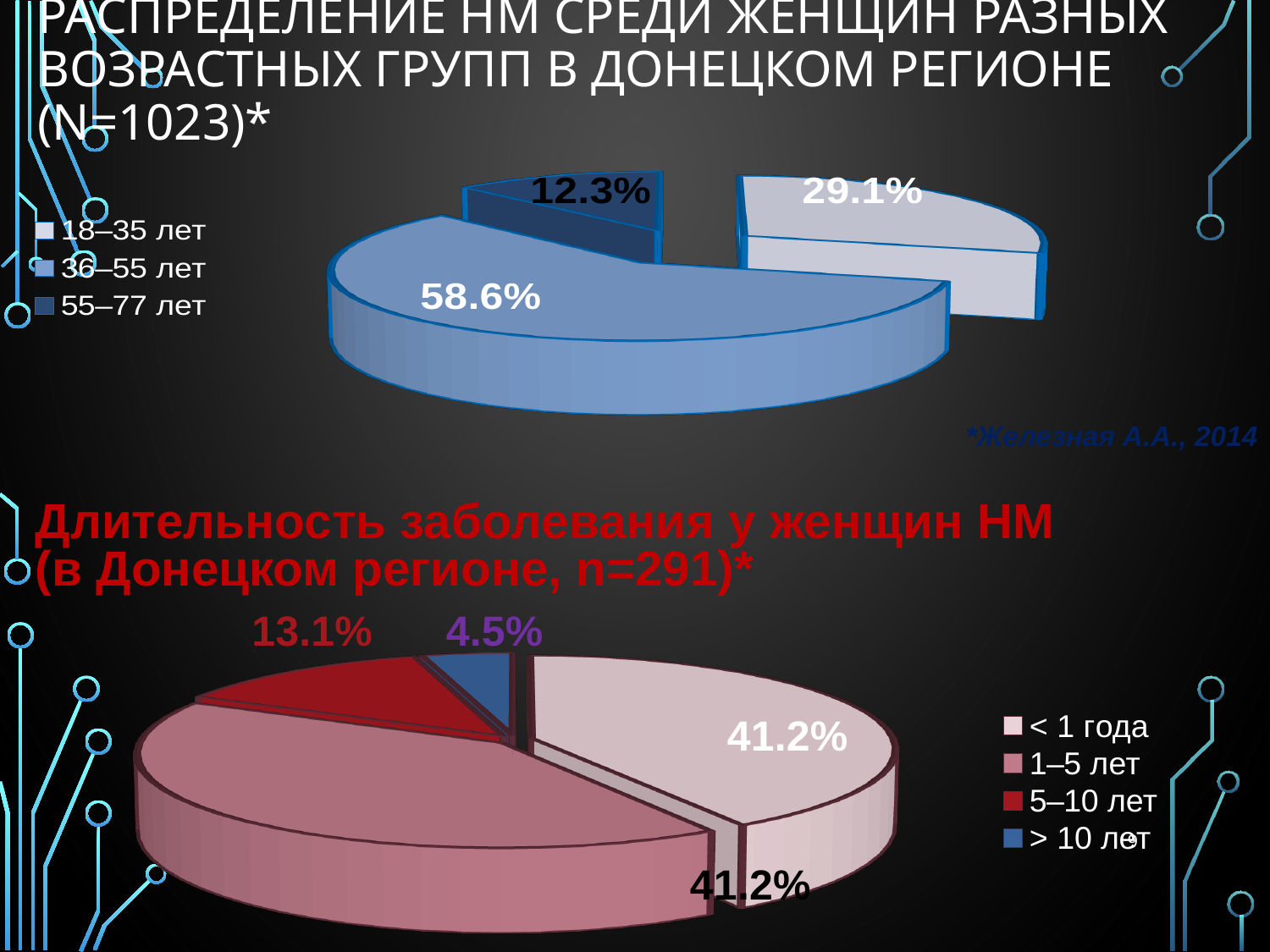
In the top chart (age distribution, N=1023), which age group has the largest share? 36–55 лет In the top chart (age distribution, N=1023), what is the difference between the 36–55 лет and 18–35 лет shares? 29.5% In the bottom chart (Длительность заболевания, n=291), which is larger: the 5–10 лет share or the > 10 лет share? 5–10 лет In the top chart (age distribution, N=1023), what share is the 55–77 лет group? 12.3% In the bottom chart (Длительность заболевания, n=291), what share is the 5–10 лет category? 13.1% What type of chart is the bottom chart (Длительность заболевания, n=291)? pie chart In the bottom chart (Длительность заболевания, n=291), which category has the smallest share? > 10 лет In the top chart (age distribution, N=1023), what share is the 36–55 лет group? 58.6% In the top chart (age distribution, N=1023), which age group has the smallest share? 55–77 лет In the top chart (age distribution, N=1023), what share is the 18–35 лет group? 29.1% In the bottom chart (Длительность заболевания, n=291), how many categories does the legend list? 4 In the top chart (age distribution, N=1023), how many age groups are shown? 3